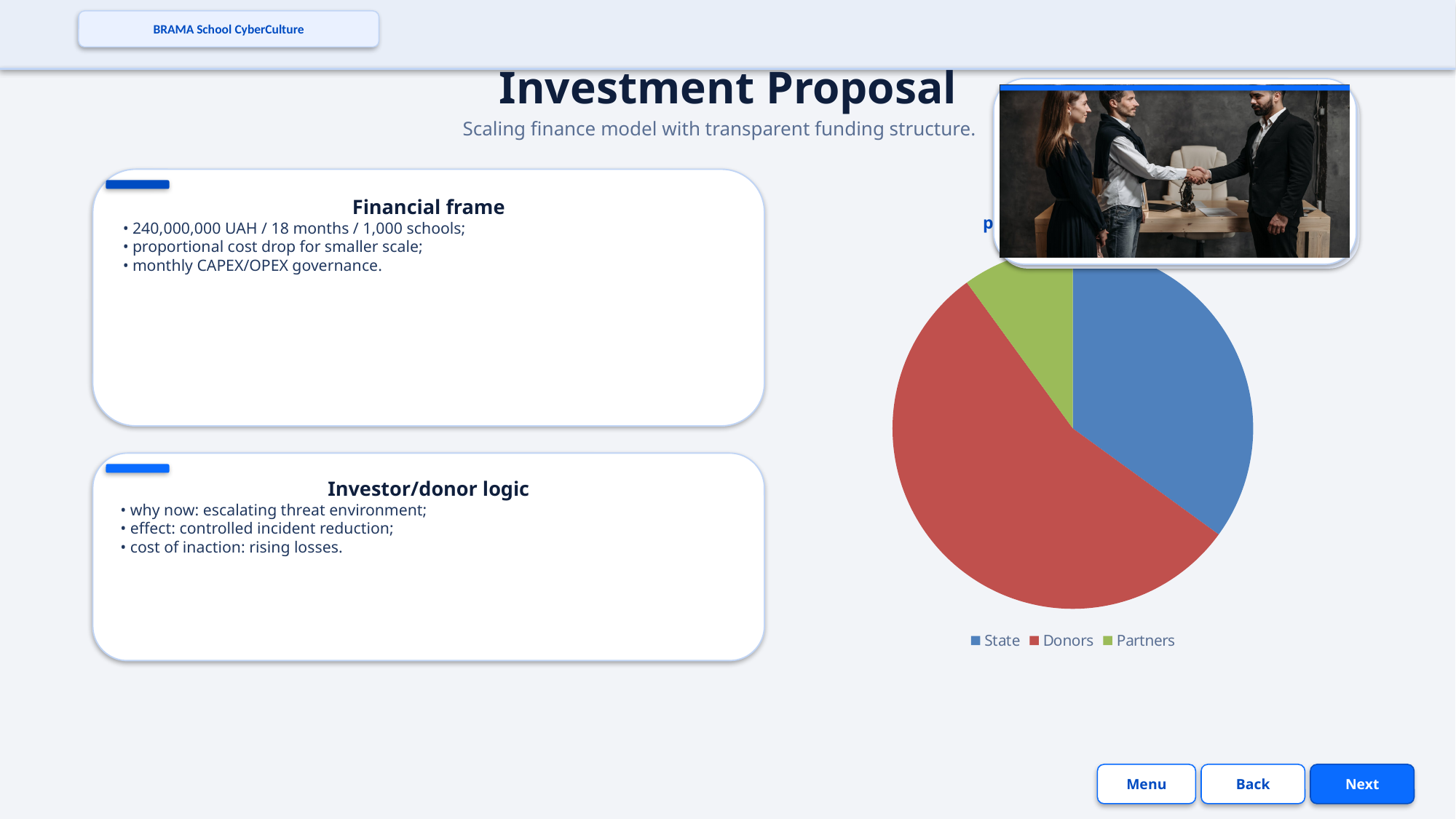
What kind of chart is shown on the slide? Pie chart How many entries does the pie chart's legend list? 3 How many slices does the pie chart have? 3 Which slice is larger in the pie chart, State or Partners? State Which category has the smallest slice of the pie chart? Partners Which category has the largest slice of the pie chart? Donors Which slice is larger in the pie chart, Partners or Donors? Donors What are the legend entries of the pie chart? State, Donors, Partners What colour is the Donors slice in the pie chart? Red Which slice is larger in the pie chart, Donors or State? Donors